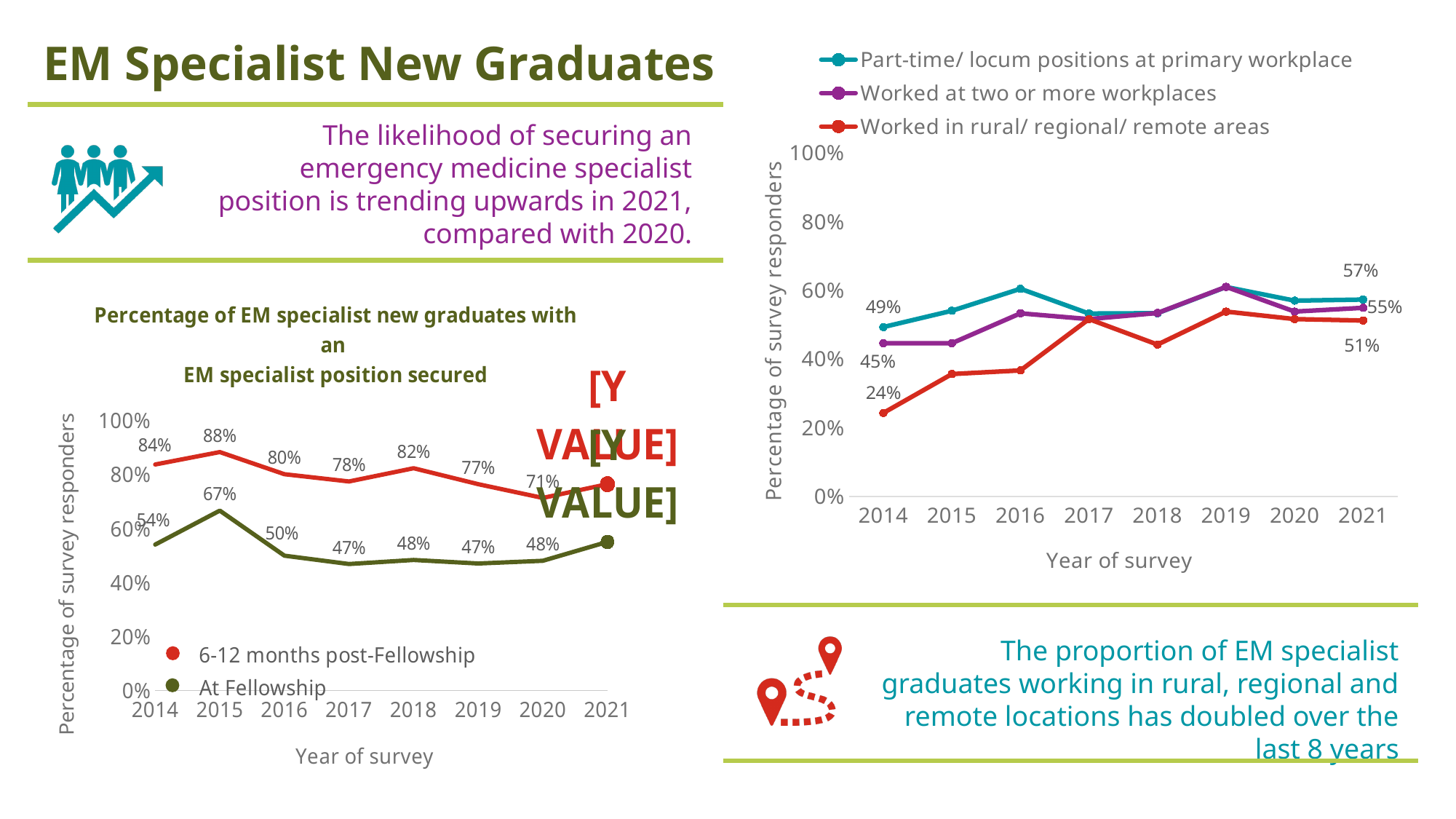
On the right chart, what was the value for Worked in rural/ regional/ remote areas in 2014? 24% On the left chart, what is the difference between the 6-12 months post-Fellowship and At Fellowship values in 2014? 30% On the left chart, in which year was the 6-12 months post-Fellowship value highest? 2015 What type of chart is the right chart? line chart On the right chart, by how much did the Worked in rural/ regional/ remote areas value increase from 2014 to 2021? 27% On the right chart, is the value for Worked in rural/ regional/ remote areas in 2016 greater or less than 40%? less On the left chart, which series has the higher value in 2018: 6-12 months post-Fellowship or At Fellowship? 6-12 months post-Fellowship On the left chart, did the 6-12 months post-Fellowship value rise or fall from 2018 to 2020? fall On the left chart, what is the At Fellowship value for 2017? 47% On the left chart, how many series does the legend list? 2 On the right chart, what was the value for Part-time/ locum positions at primary workplace in 2021? 57% On the left chart, what percentage of EM specialist new graduates had a position secured 6-12 months post-Fellowship in 2015? 88%